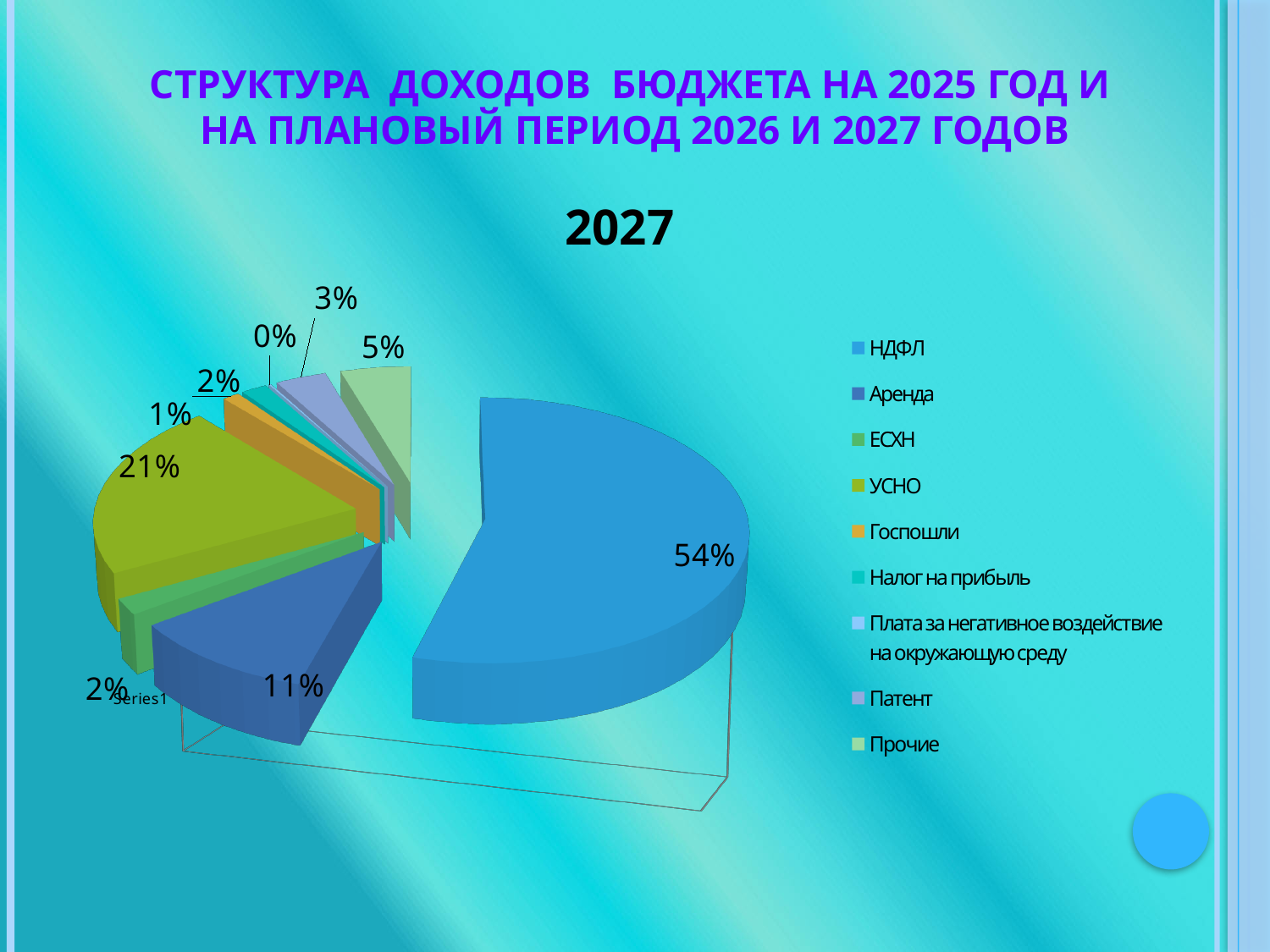
What share of the pie does НДФЛ have? 54% What is the value shown for Прочие? 5% Which is larger, the slice for УСНО or the slice for Аренда? УСНО Which category has the largest slice of the pie? НДФЛ What type of chart is shown on the slide? pie chart What is the value shown for Аренда? 11% What is the title shown above the pie chart? 2027 What is the value shown for УСНО? 21% What is the difference in percentage points between НДФЛ and УСНО? 33 How many categories does the legend list? 9 Which legend entry is listed last? Прочие What is the difference in percentage points between УСНО and Аренда? 10